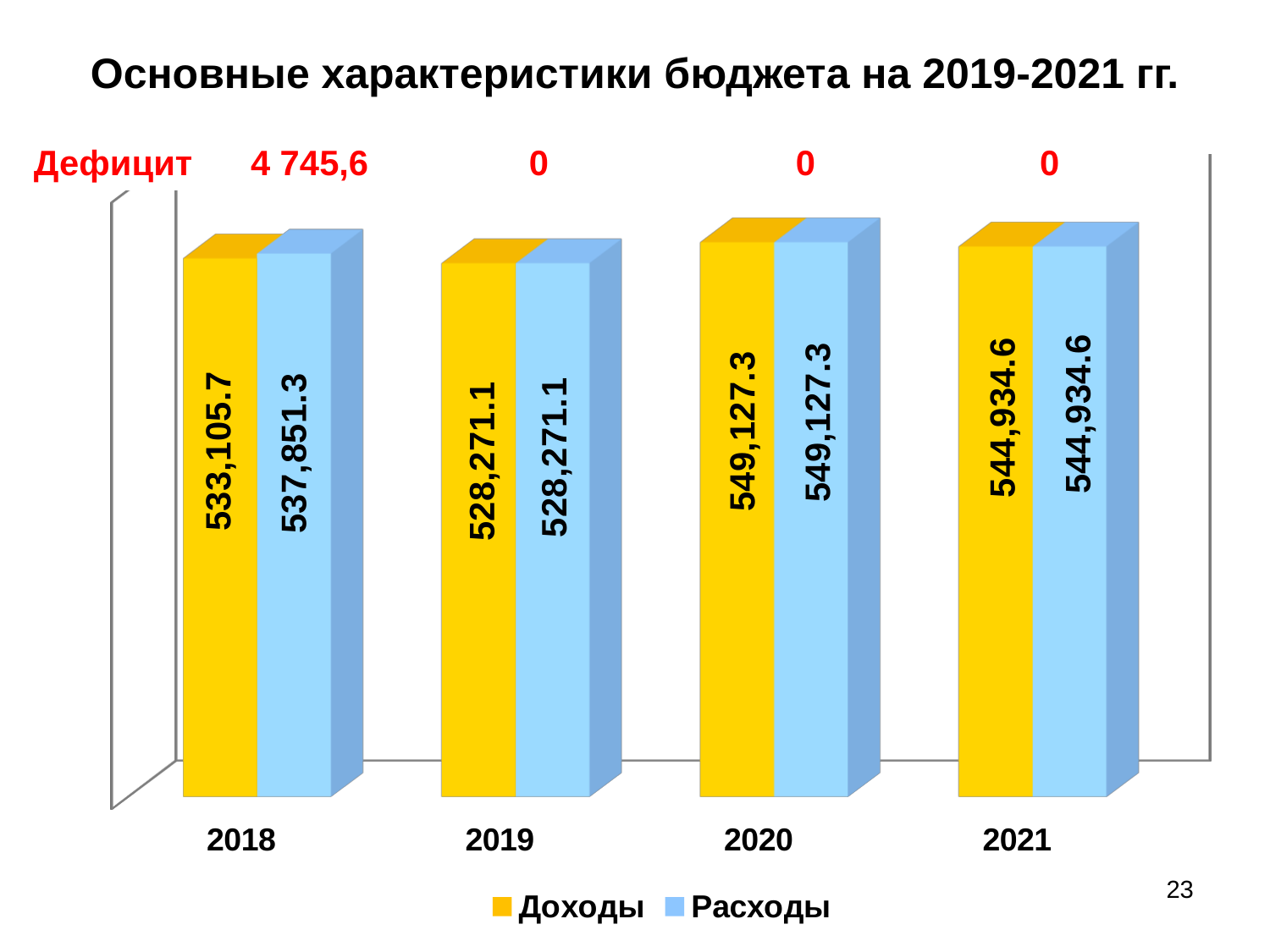
What is the value of Расходы for 2021? 544,934.6 What is the value of Расходы for 2018? 537,851.3 What is the value of Доходы for 2018? 533,105.7 Which is larger in 2018, Доходы or Расходы? Расходы What is the difference between Доходы in 2020 and Доходы in 2021? 4,192.7 In which year is Расходы the lowest? 2019 How many series does the legend list? 2 What kind of chart is shown on the slide? bar chart What is the value of Доходы for 2020? 549,127.3 In which year is Доходы the highest? 2020 What is the difference between Расходы and Доходы in 2018? 4,745.6 How many years are shown on the x axis? 4